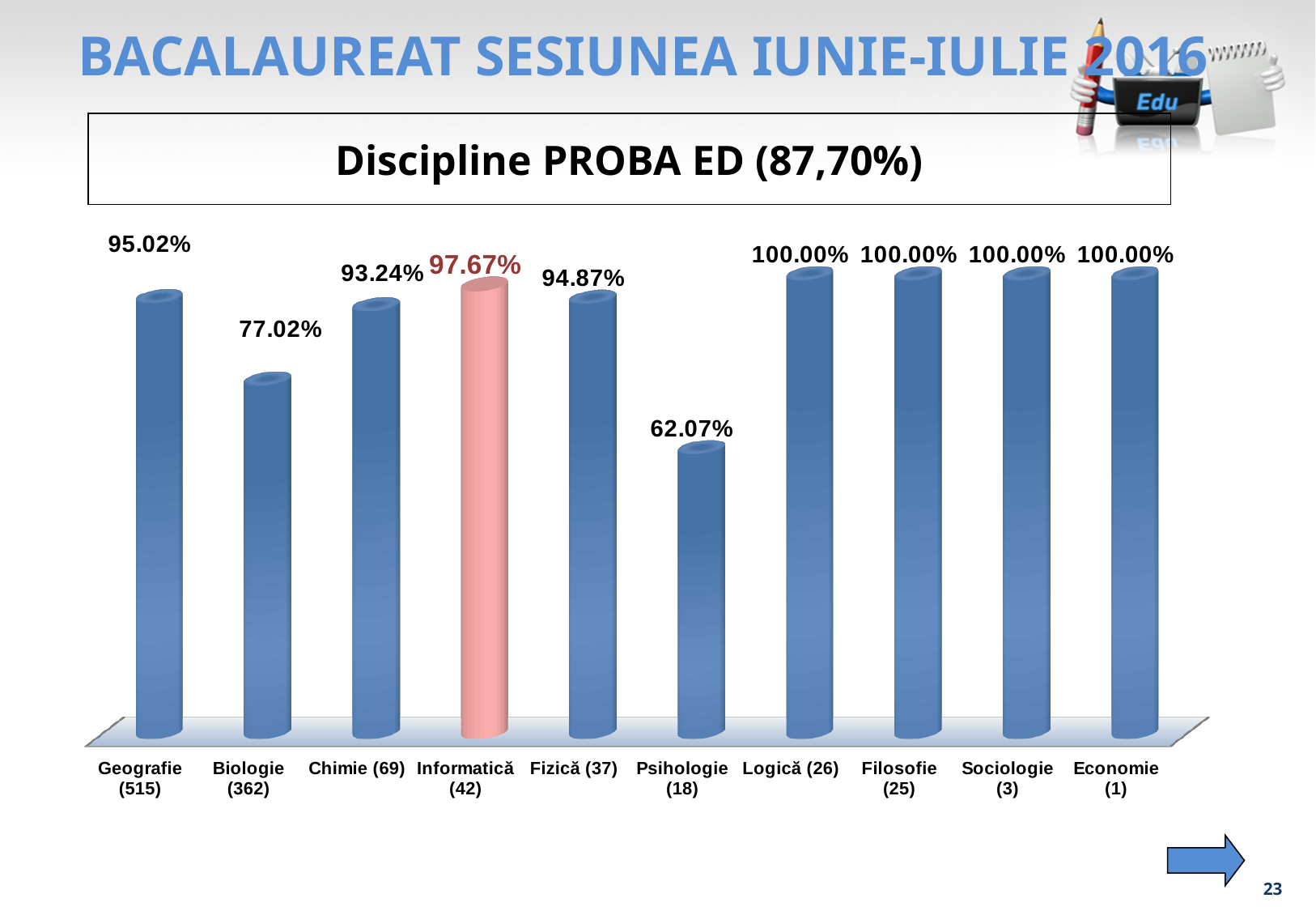
What is the difference between the values for Geografie (515) and Biologie (362)? 18.00% How many categories have a value of 100.00%? 4 What is the value for Biologie (362)? 77.02% What kind of chart is shown on the slide? Bar chart What is the difference between the values for Informatică (42) and Chimie (69)? 4.43% What is the value for Informatică (42)? 97.67% How many categories are shown on the chart? 10 Which is larger, the value for Fizică (37) or the value for Chimie (69)? Fizică (37) What is the value for Geografie (515)? 95.02% What is the value for Psihologie (18)? 62.07% Which category has the lowest value? Psihologie (18) Which bar is coloured differently (pink) from the others? Informatică (42)